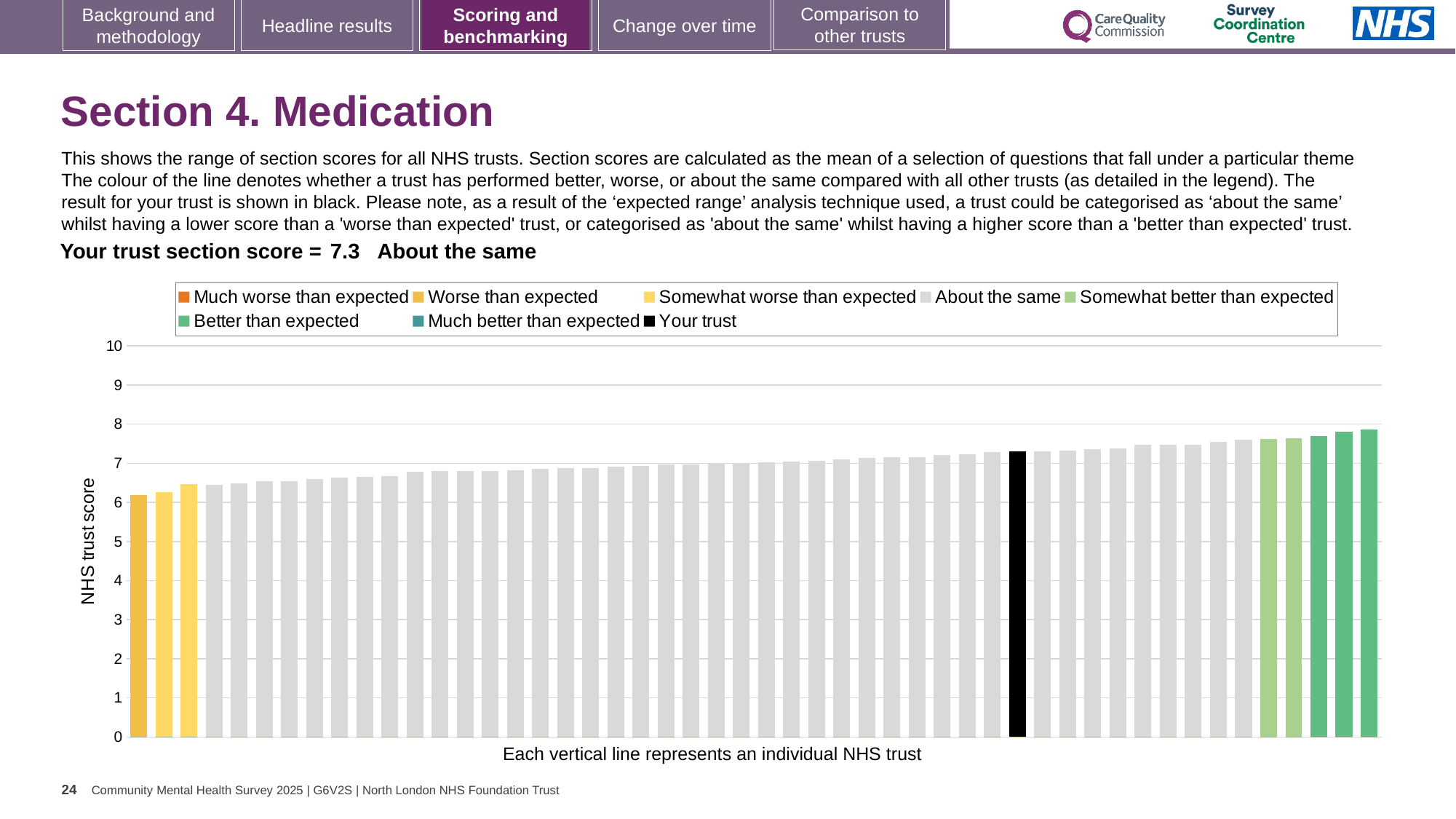
What kind of chart is shown on the slide? Bar chart Do the bar values rise or fall from left to right along the x axis? rise How many entries does the chart legend list? 8 Is the value of the rightmost bar greater or less than 8? less Is the highest bar at the left end or the right end of the chart? Right end What is the label on the vertical axis of the chart? NHS trust score What is the section score for your trust shown on the slide? 7.3 What colour is the bar representing your trust? Black Is the value of the leftmost bar greater or less than 7? less Is the value of the black 'Your trust' bar greater or less than 7? greater Which is taller: the black 'Your trust' bar or the leftmost bar? The black 'Your trust' bar Which category is your trust placed in for this section? About the same